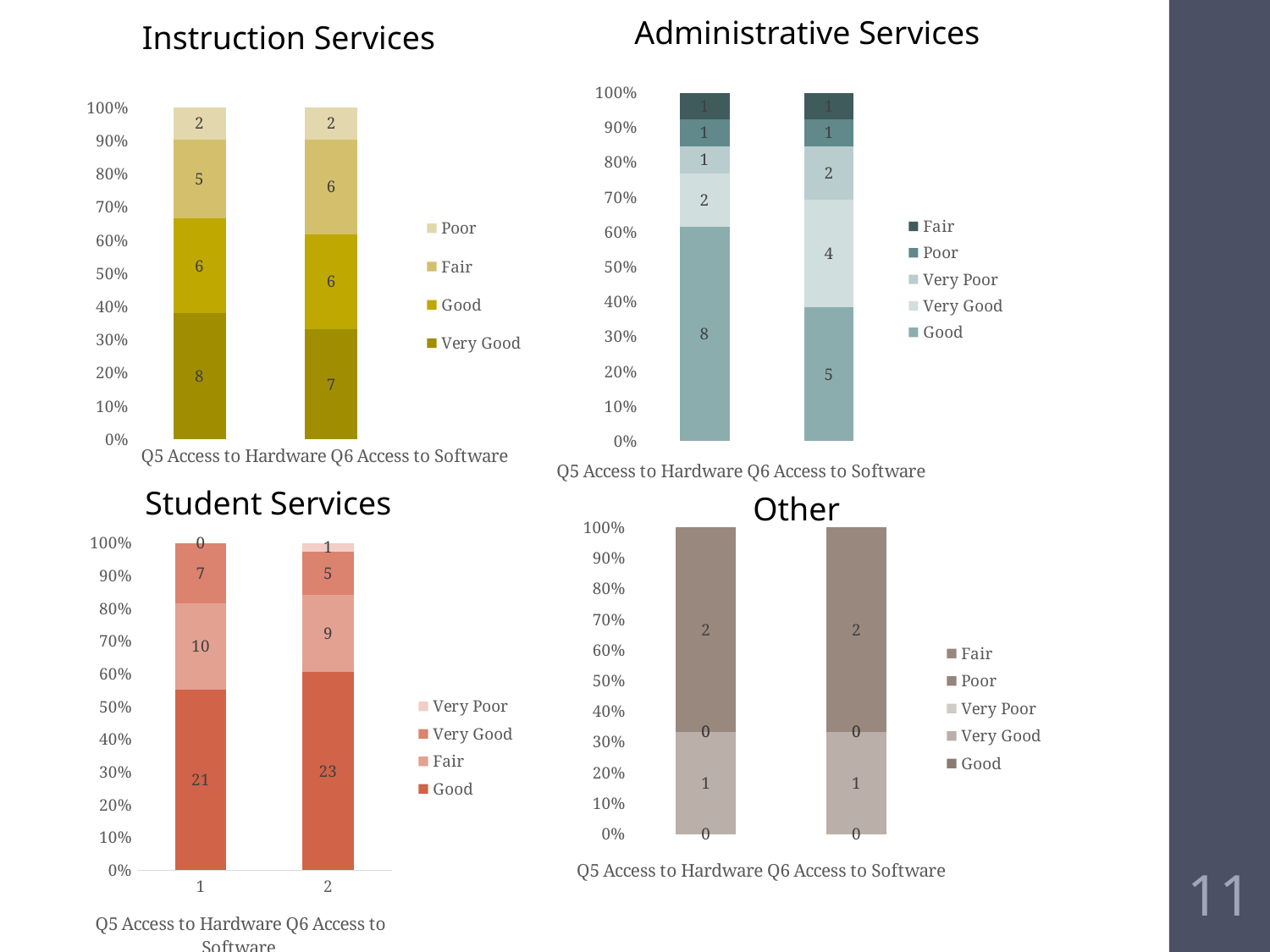
In the Student Services chart, which bar has the larger Fair value, Q5 Access to Hardware or Q6 Access to Software? Q5 Access to Hardware In the Student Services chart, what is the total of all segments in the Q5 Access to Hardware bar? 38 How many series does the legend of the Administrative Services chart list? 5 In the Instruction Services chart, what is the total of all segments in the Q5 Access to Hardware bar? 21 In the Administrative Services chart, what is the difference between the Good values for Q5 Access to Hardware and Q6 Access to Software? 3 In the Administrative Services chart, what is the value of the Good segment for Q5 Access to Hardware? 8 In the Instruction Services chart, what is the value of the Fair segment for Q6 Access to Software? 6 In the Student Services chart, what is the value of the Good segment for Q6 Access to Software? 23 In the Administrative Services chart, what is the value of the Very Good segment for Q6 Access to Software? 4 How many series does the legend of the Other chart list? 5 In the Instruction Services chart, what is the value of the Very Good segment for Q5 Access to Hardware? 8 What kind of chart is the Instruction Services chart? Stacked bar chart